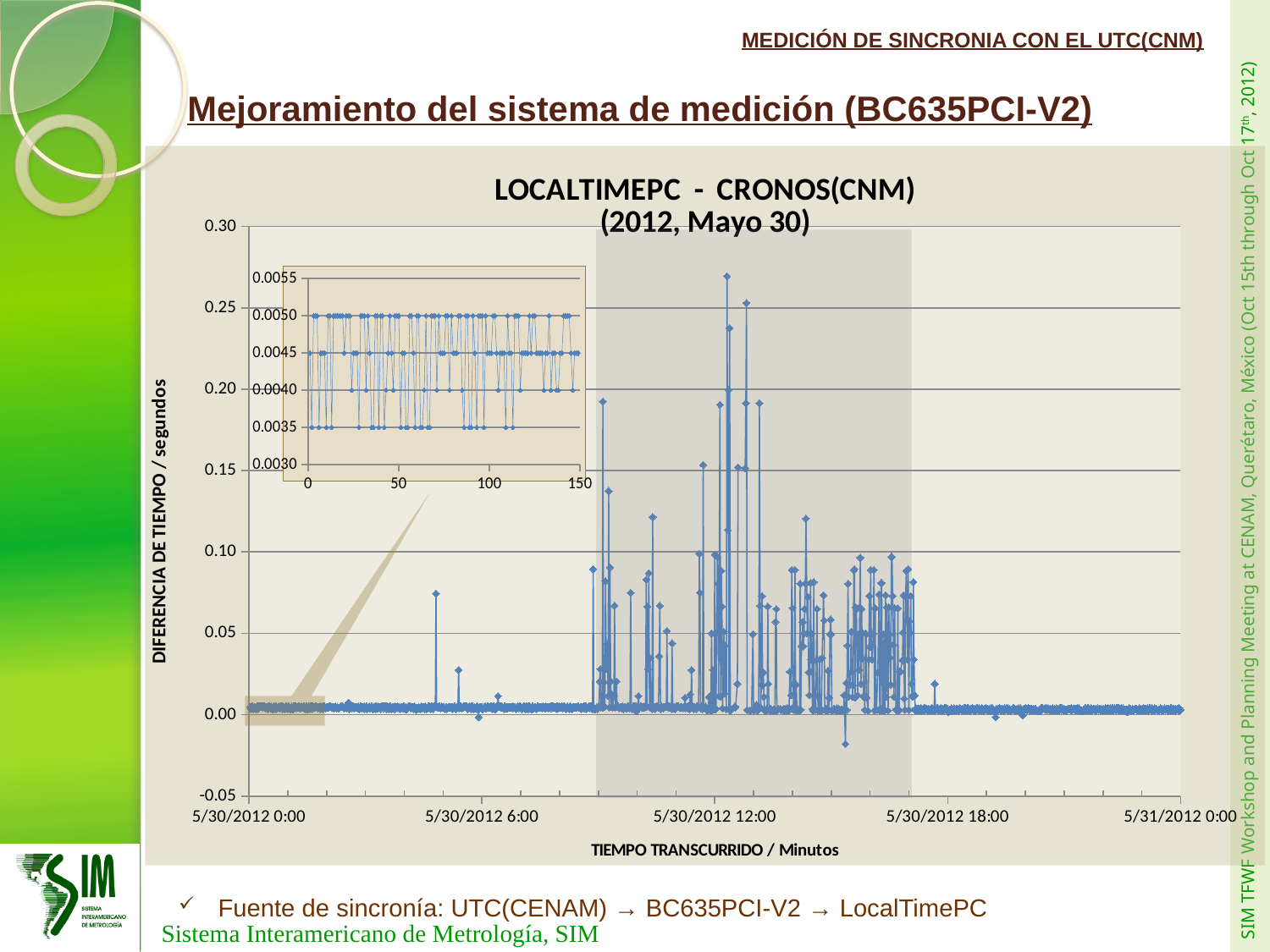
What is the largest tick value on the horizontal axis of the inset chart? 150 In the inset chart, is the lowest plotted value greater or less than 0.0040? less What kind of chart is the main chart on the slide? line chart What is the label of the vertical axis of the main chart? DIFERENCIA DE TIEMPO / segundos What is the lowest value shown on the vertical axis of the main chart? -0.05 In the inset chart, is the highest plotted value greater or less than 0.0045? greater In the main chart, is the highest spike (around 5/30/2012 12:00) greater or less than 0.25? greater